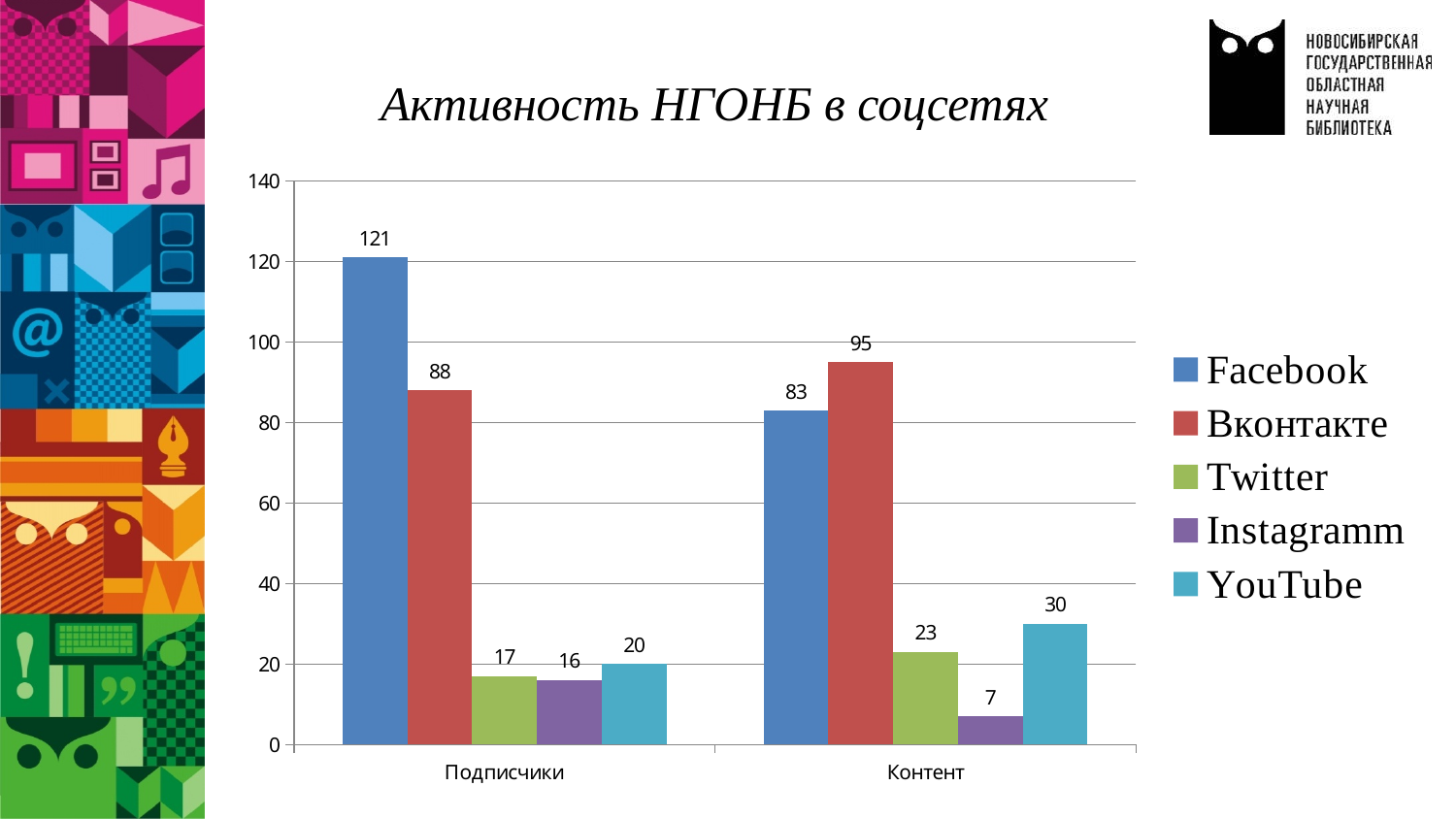
What kind of chart is shown on the slide? Bar chart How many series does the legend list? 5 What is the value for Вконтакте in the Контент category? 95 What is the difference between the Facebook and Вконтакте values in the Подписчики category? 33 What is the value for Facebook in the Подписчики category? 121 What is the value for YouTube in the Подписчики category? 20 Which series has the lowest value in the Контент category? Instagramm Which series has the highest value in the Подписчики category? Facebook Which is larger in the Контент category: Facebook or Вконтакте? Вконтакте What is the value for Instagramm in the Контент category? 7 What is the title of the chart? Активность НГОНБ в соцсетях How many categories are shown on the x axis? 2